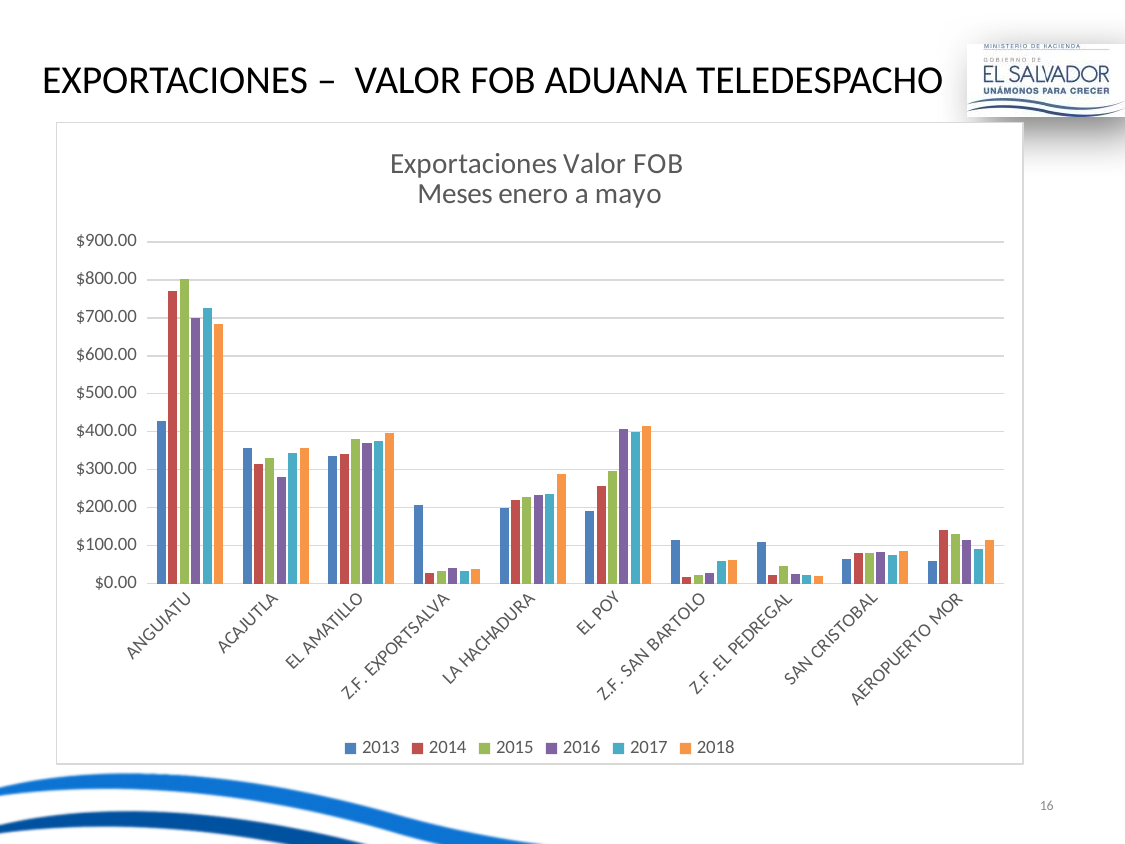
What is the title of the chart? Exportaciones Valor FOB Meses enero a mayo Is the 2016 value for EL POY greater or less than $300.00? greater Is the 2013 value for Z.F. EXPORTSALVA greater or less than $100.00? greater Which year has the highest value for ANGUIATU? 2015 How many series does the legend list? 6 For ANGUIATU, which is larger: the 2014 value or the 2016 value? 2014 Is the 2015 value for ANGUIATU greater or less than $700.00? greater How many customs offices (categories) are shown on the x axis? 10 What kind of chart is shown on the slide? bar chart Which category has the tallest bar in the chart? ANGUIATU For Z.F. EXPORTSALVA, which is larger: the 2013 value or the 2018 value? 2013